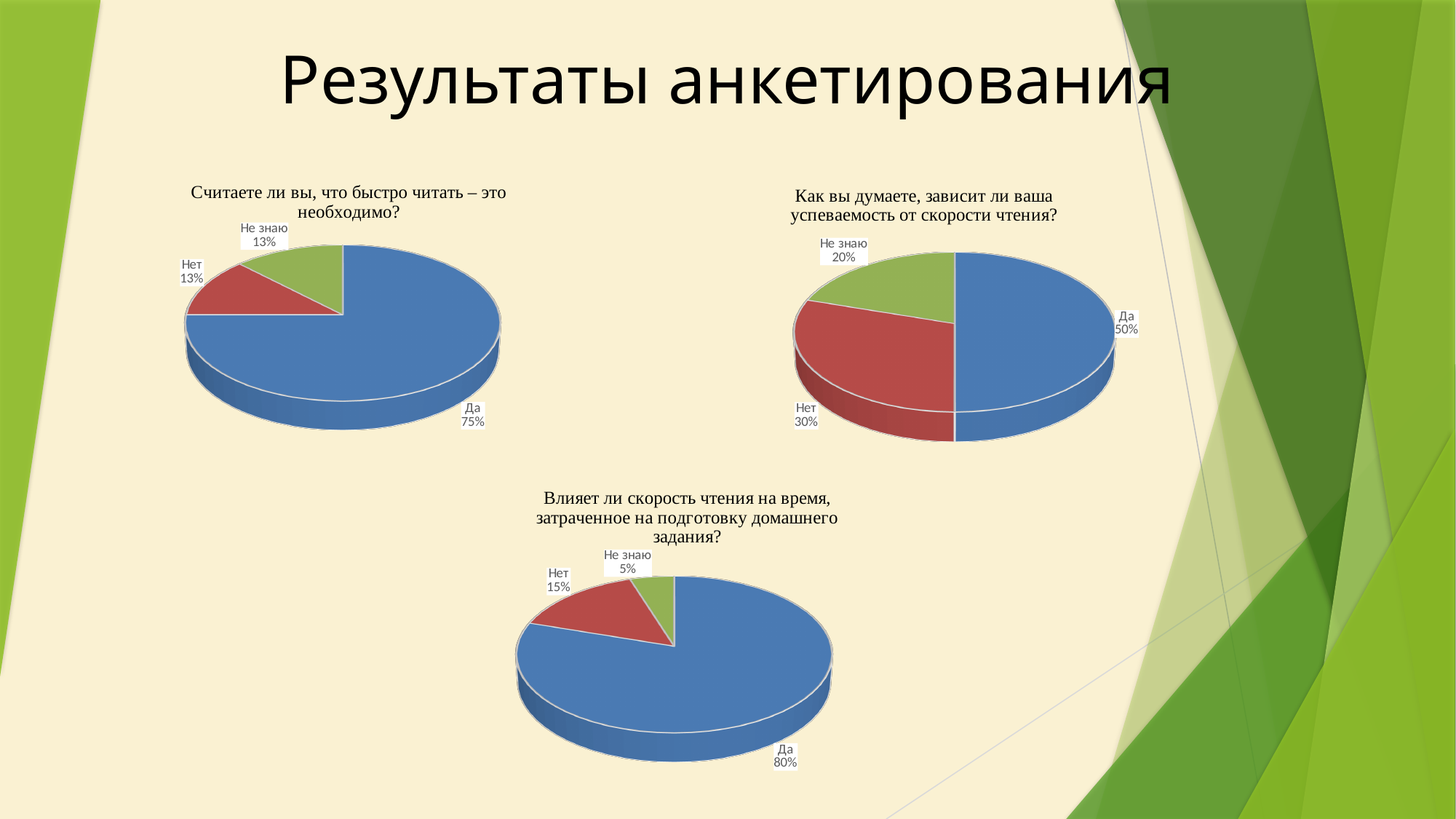
In the top-right chart (Как вы думаете, зависит ли ваша успеваемость от скорости чтения?), which answer has the largest slice? Да What type of chart is the top-right chart (Как вы думаете, зависит ли ваша успеваемость от скорости чтения?)? Pie chart How many slices does the top-left chart (Считаете ли вы, что быстро читать – это необходимо?) have? 3 In the top-right chart (Как вы думаете, зависит ли ваша успеваемость от скорости чтения?), what is the difference in percentage points between Да and Нет? 20 In the bottom chart (Влияет ли скорость чтения на время, затраченное на подготовку домашнего задания?), what share of respondents answered Да? 80% In the top-left chart (Считаете ли вы, что быстро читать – это необходимо?), what share of respondents answered Да? 75% In the top-right chart (Как вы думаете, зависит ли ваша успеваемость от скорости чтения?), what share of respondents answered Не знаю? 20% In the bottom chart (Влияет ли скорость чтения на время, затраченное на подготовку домашнего задания?), which is larger: Нет or Не знаю? Нет In the bottom chart (Влияет ли скорость чтения на время, затраченное на подготовку домашнего задания?), which answer has the smallest slice? Не знаю In the top-left chart (Считаете ли вы, что быстро читать – это необходимо?), what share of respondents answered Нет? 13% In the top-right chart (Как вы думаете, зависит ли ваша успеваемость от скорости чтения?), which answer has the smallest slice? Не знаю In the bottom chart (Влияет ли скорость чтения на время, затраченное на подготовку домашнего задания?), what is the difference in percentage points between Да and Нет? 65